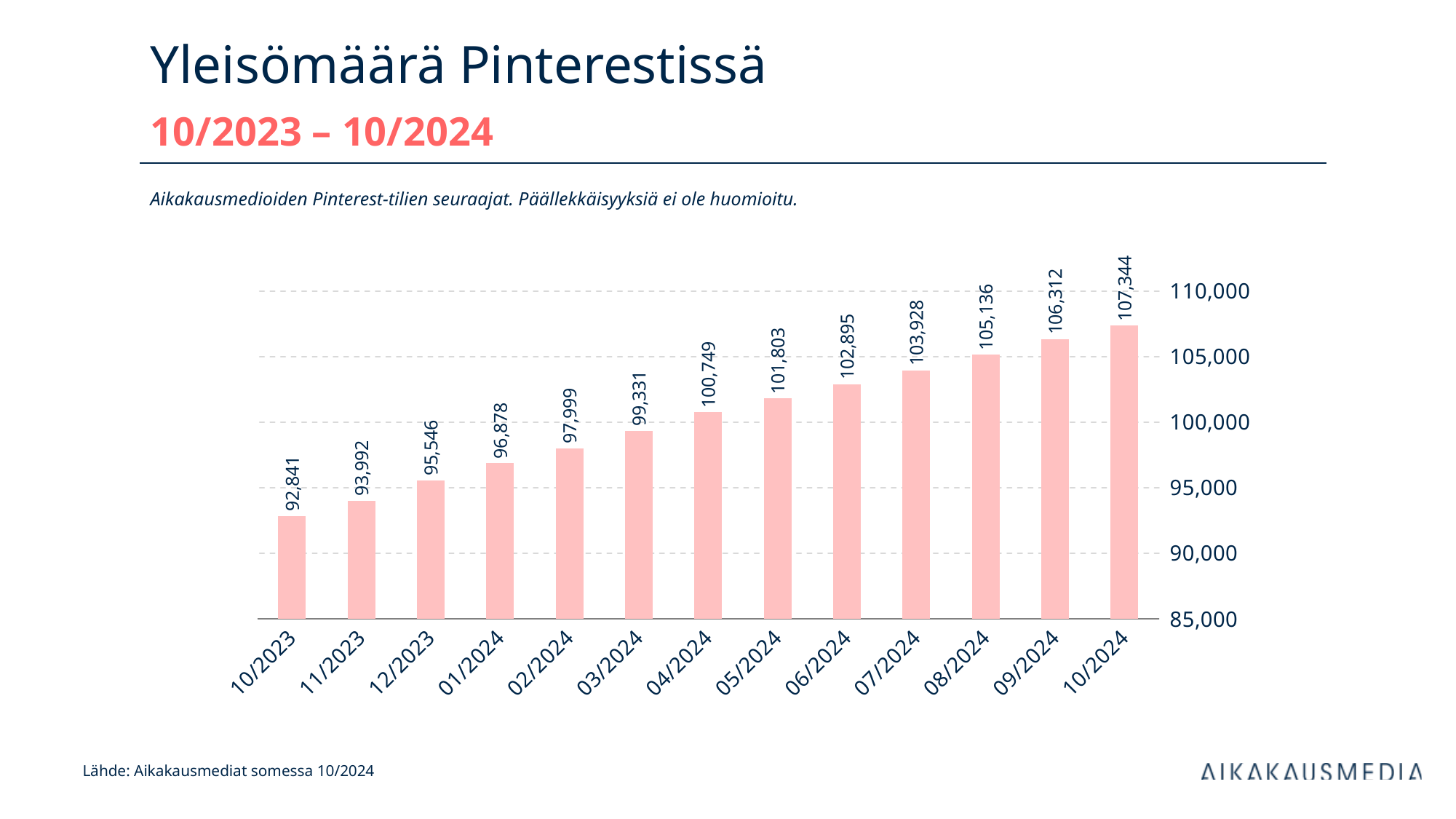
What is the difference between the values for 09/2024 and 08/2024? 1,176 Which month has the highest value? 10/2024 Which is larger, the value for 03/2024 or the value for 06/2024? 06/2024 What is the value for 10/2024? 107,344 What kind of chart is shown on the slide? bar chart What is the value for 04/2024? 100,749 Is the value for 02/2024 greater or less than 100,000? less Which month has the lowest value? 10/2023 Do the values rise or fall from 10/2023 to 10/2024? rise What is the value for 10/2023? 92,841 What is the difference between the values for 10/2024 and 10/2023? 14,503 How many months are shown on the x axis? 13